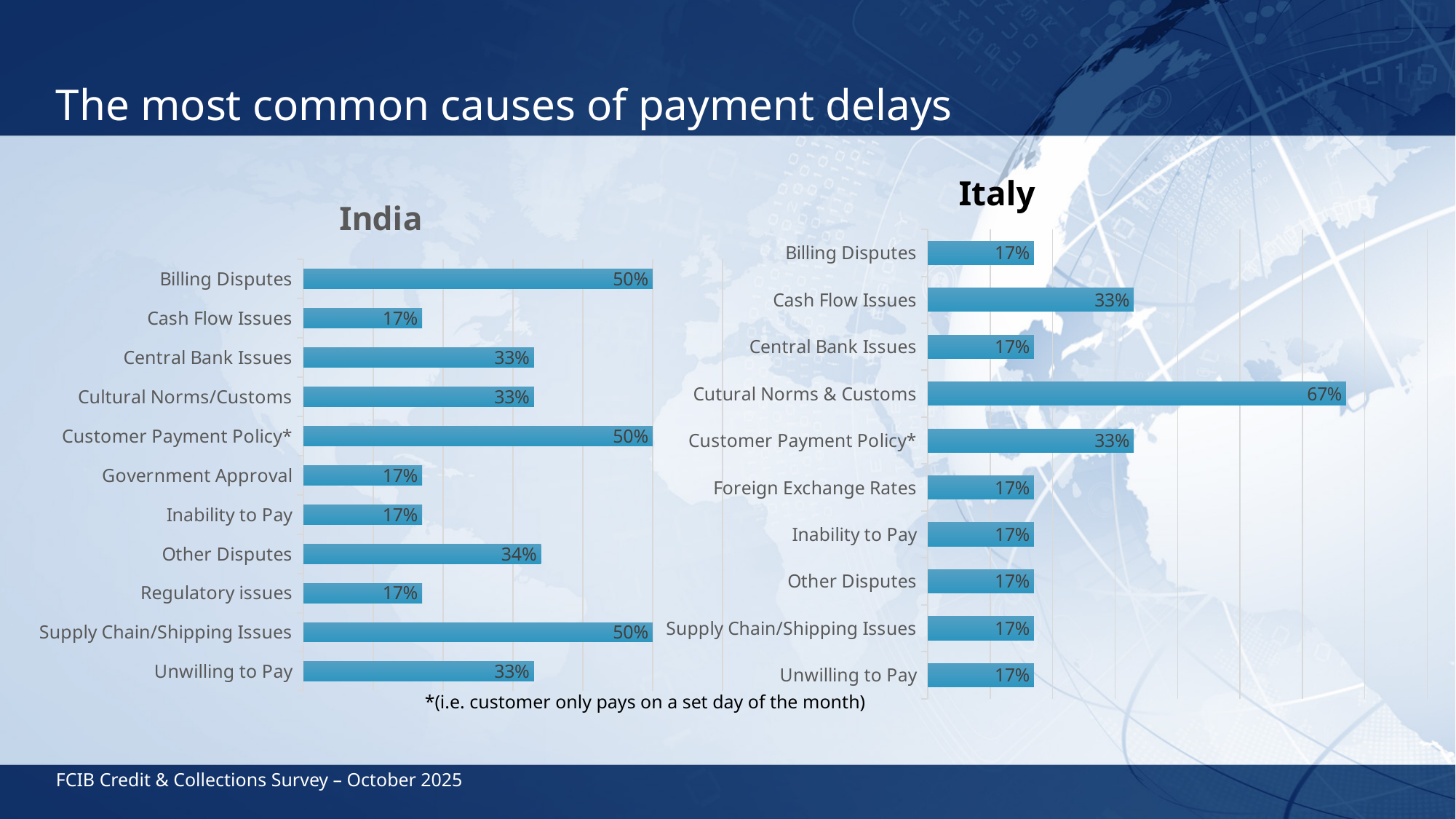
In the India chart, what is the difference between Billing Disputes and Cash Flow Issues? 33% In the Italy chart, what is the value for Cash Flow Issues? 33% In the India chart, which category has the lowest value among Billing Disputes, Cash Flow Issues and Central Bank Issues? Cash Flow Issues In the Italy chart, what is the value for Cutural Norms & Customs? 67% In the India chart, what is the value for Other Disputes? 34% Which is larger: Cash Flow Issues in the India chart or Cash Flow Issues in the Italy chart? Italy How many categories are shown in the India chart? 11 In the Italy chart, what is the difference between Cutural Norms & Customs and Customer Payment Policy*? 34% In the Italy chart, which category has the highest value? Cutural Norms & Customs In the India chart, what is the value for Billing Disputes? 50% What type of chart is the India chart? Bar chart How many categories are shown in the Italy chart? 10